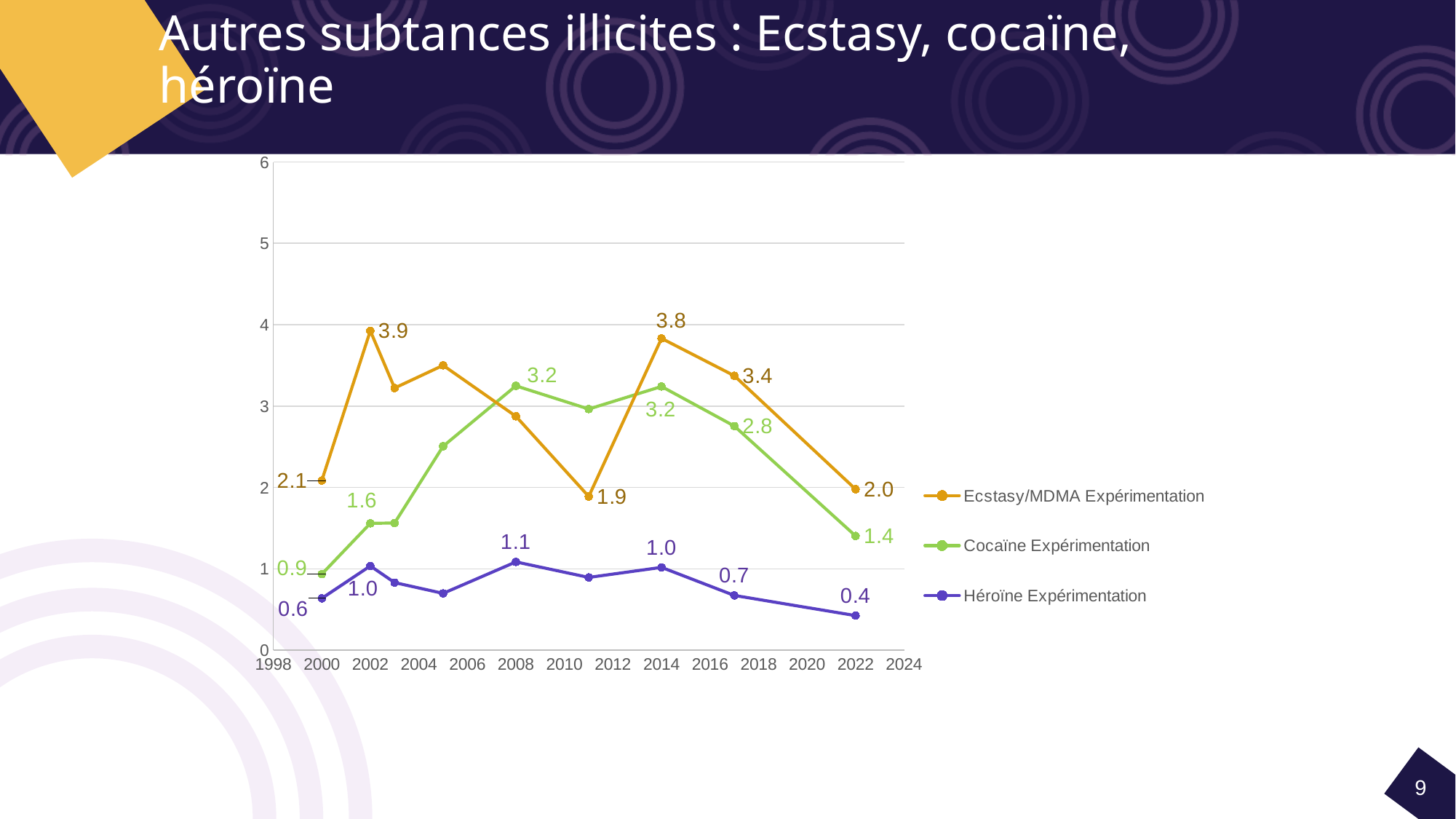
What is the value for Ecstasy/MDMA Expérimentation in 2002? 3.9 What is the value for Ecstasy/MDMA Expérimentation in 2014? 3.8 Does the Cocaïne Expérimentation series rise or fall between 2014 and 2022? fall Which series has the lowest value in 2022? Héroïne Expérimentation What is the difference between the Ecstasy/MDMA Expérimentation values in 2002 and 2022? 1.9 How many series does the legend list? 3 What is the value for Cocaïne Expérimentation in 2022? 1.4 How many data points does the Héroïne Expérimentation series have? 9 Is the value for Cocaïne Expérimentation in 2005 greater or less than 3? less What type of chart is shown on the slide? line chart Which is larger in 2017: Ecstasy/MDMA Expérimentation or Cocaïne Expérimentation? Ecstasy/MDMA Expérimentation What is the value for Héroïne Expérimentation in 2008? 1.1